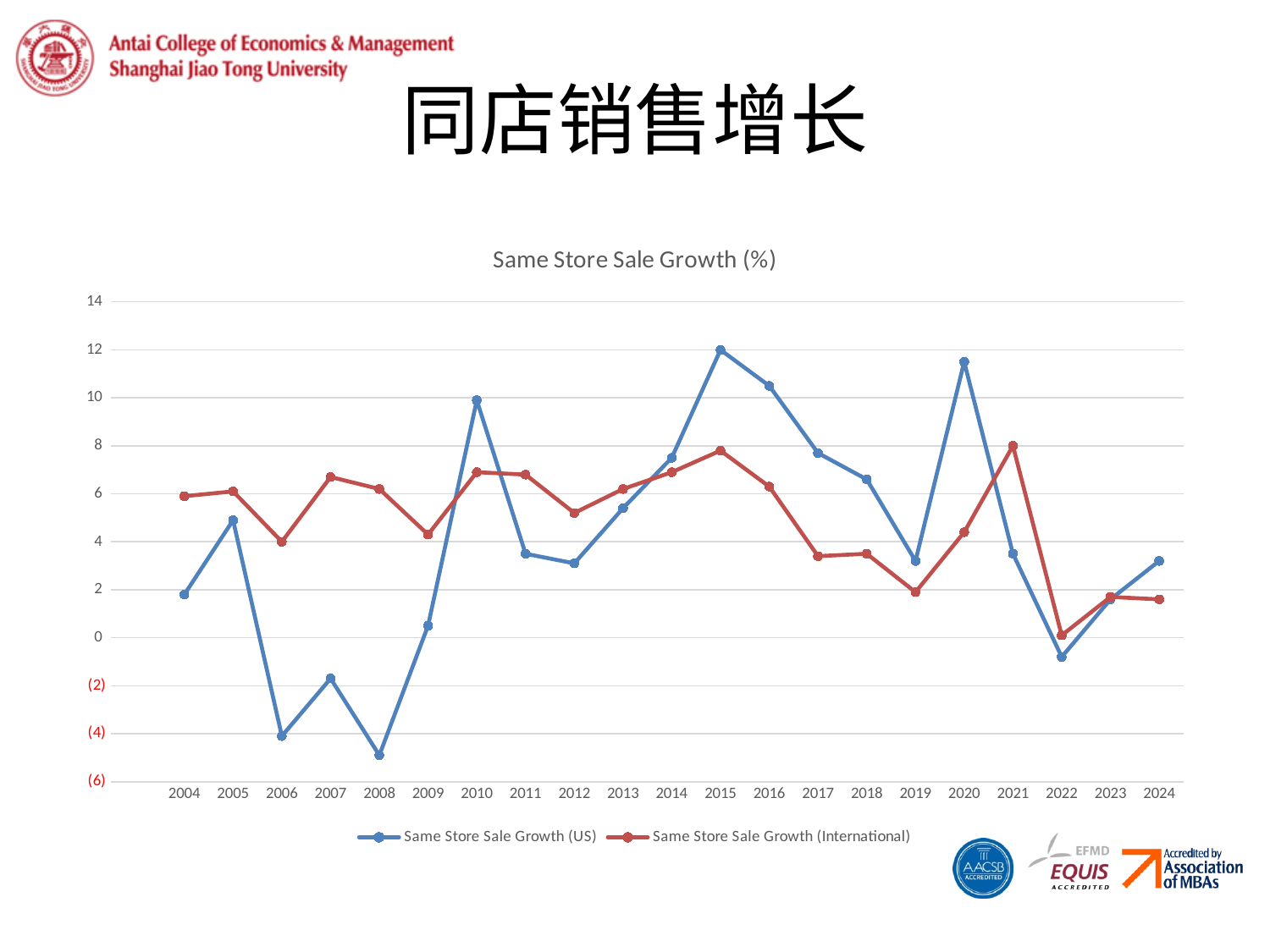
How many series does the legend list? 2 Is the value for Same Store Sale Growth (International) in 2004 greater or less than 4? greater Does Same Store Sale Growth (US) rise or fall from 2015 to 2019? fall In which year is Same Store Sale Growth (International) at its lowest? 2022 Is the value for Same Store Sale Growth (US) in 2008 greater or less than (4)? less In which year is Same Store Sale Growth (US) at its highest? 2015 Is the value for Same Store Sale Growth (US) in 2010 greater or less than 8? greater How many years are plotted along the x axis? 21 What kind of chart is shown on the slide? line chart What is the title of the chart? Same Store Sale Growth (%) In which year is Same Store Sale Growth (US) at its lowest? 2008 In 2006, which series has the larger value, US or International? International